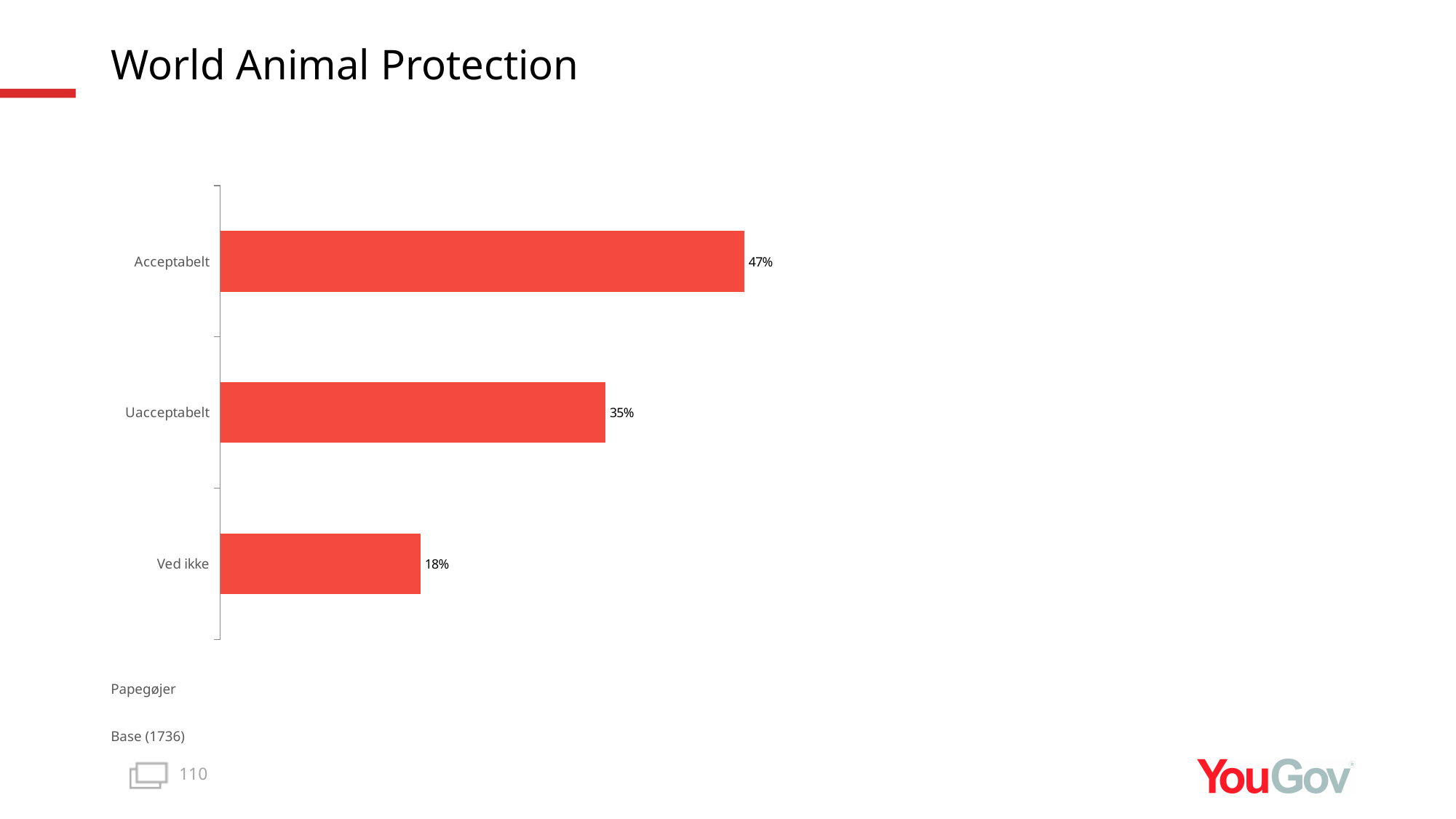
What is the difference between Uacceptabelt and Ved ikke? 17% What is the value for Acceptabelt? 47% What is the base (number of respondents) shown below the chart? 1736 What is the value for Uacceptabelt? 35% How many categories are shown in the chart? 3 What is the value for Ved ikke? 18% What colour are the bars in the chart? Red Which category has the highest value? Acceptabelt What kind of chart is shown on the slide? Bar chart Which is larger, Uacceptabelt or Ved ikke? Uacceptabelt What is the difference between Acceptabelt and Uacceptabelt? 12% Which category has the lowest value? Ved ikke